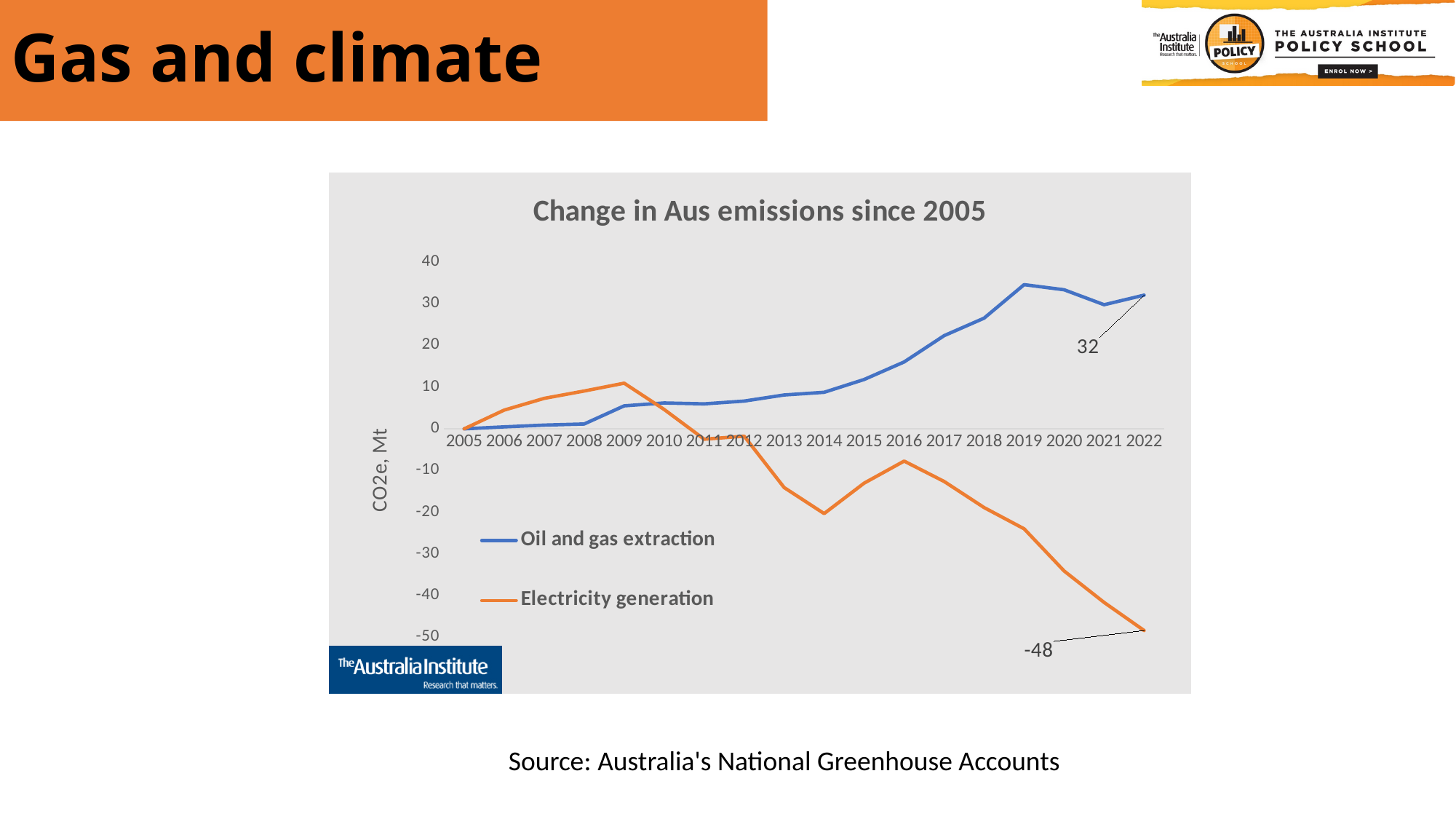
What is the value for Oil and gas extraction in 2022? 32 In which year is the Electricity generation value lowest? 2022 What kind of chart is shown? line chart What is the difference between the Oil and gas extraction value and the Electricity generation value in 2022? 80 How many years are shown on the x axis? 18 Is the value for Electricity generation in 2014 greater or less than -10? less Is the value for Oil and gas extraction in 2016 greater or less than 10? greater How many series does the legend list? 2 What is the value for Electricity generation in 2022? -48 Does the Electricity generation line rise or fall from 2016 to 2022? fall In 2022, which series has the larger value: Oil and gas extraction or Electricity generation? Oil and gas extraction Is the value for Oil and gas extraction in 2019 greater or less than 30? greater